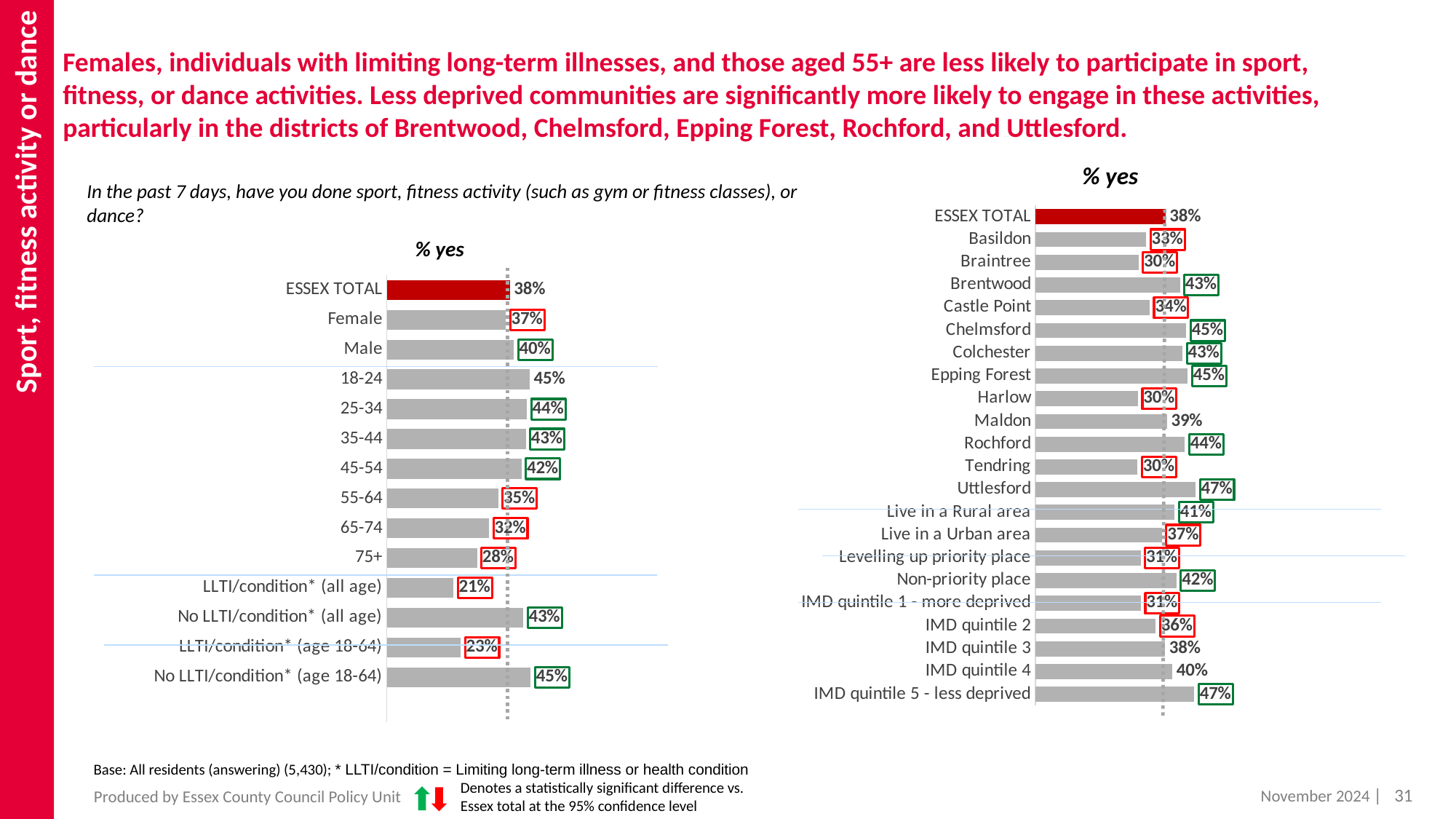
In the right chart, what is the difference between IMD quintile 5 - less deprived and IMD quintile 1 - more deprived? 16% In the right chart, which is larger, Live in a Rural area or Live in a Urban area? Live in a Rural area In the right chart, which district has the highest value? Uttlesford In the right chart, what is the value for Harlow? 30% In the left chart, which is larger, 18-24 or 55-64? 18-24 In the left chart, what is the value for Female? 37% In the left chart, which category has the lowest value? LLTI/condition* (all age) In the left chart, how many categories are plotted? 14 In the left chart, what is the value for 75+? 28% In the left chart, what is the difference between Male and Female? 3% What type of chart is shown on the left of the slide? Bar chart In the right chart, what is the value for Uttlesford? 47%